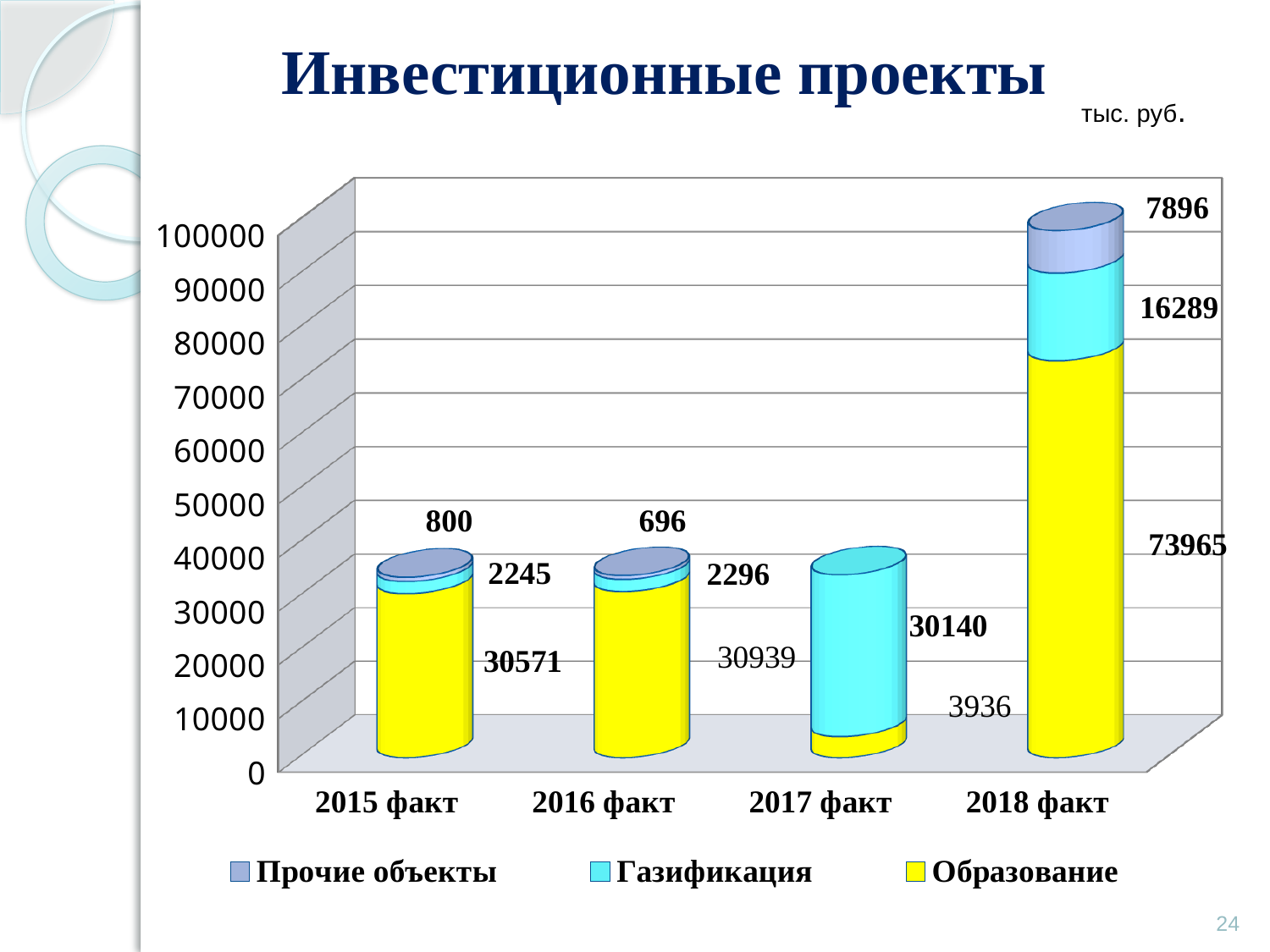
What is the difference between the Газификация values for 2018 факт and 2016 факт? 13993 What is the value for Газификация in 2017 факт? 30140 How many categories are shown on the x axis? 4 Which year has the lowest value for Образование? 2017 факт What is the total of the stacked bar for 2015 факт? 33616 What is the value for Образование in 2018 факт? 73965 Which is larger: Прочие объекты in 2015 факт or in 2016 факт? 2015 факт Which year has the highest value for Образование? 2018 факт What is the value for Прочие объекты in 2016 факт? 696 Is the total height of the 2018 факт bar greater or less than 90000? greater What kind of chart is shown on the slide? stacked bar chart How many series does the legend list? 3